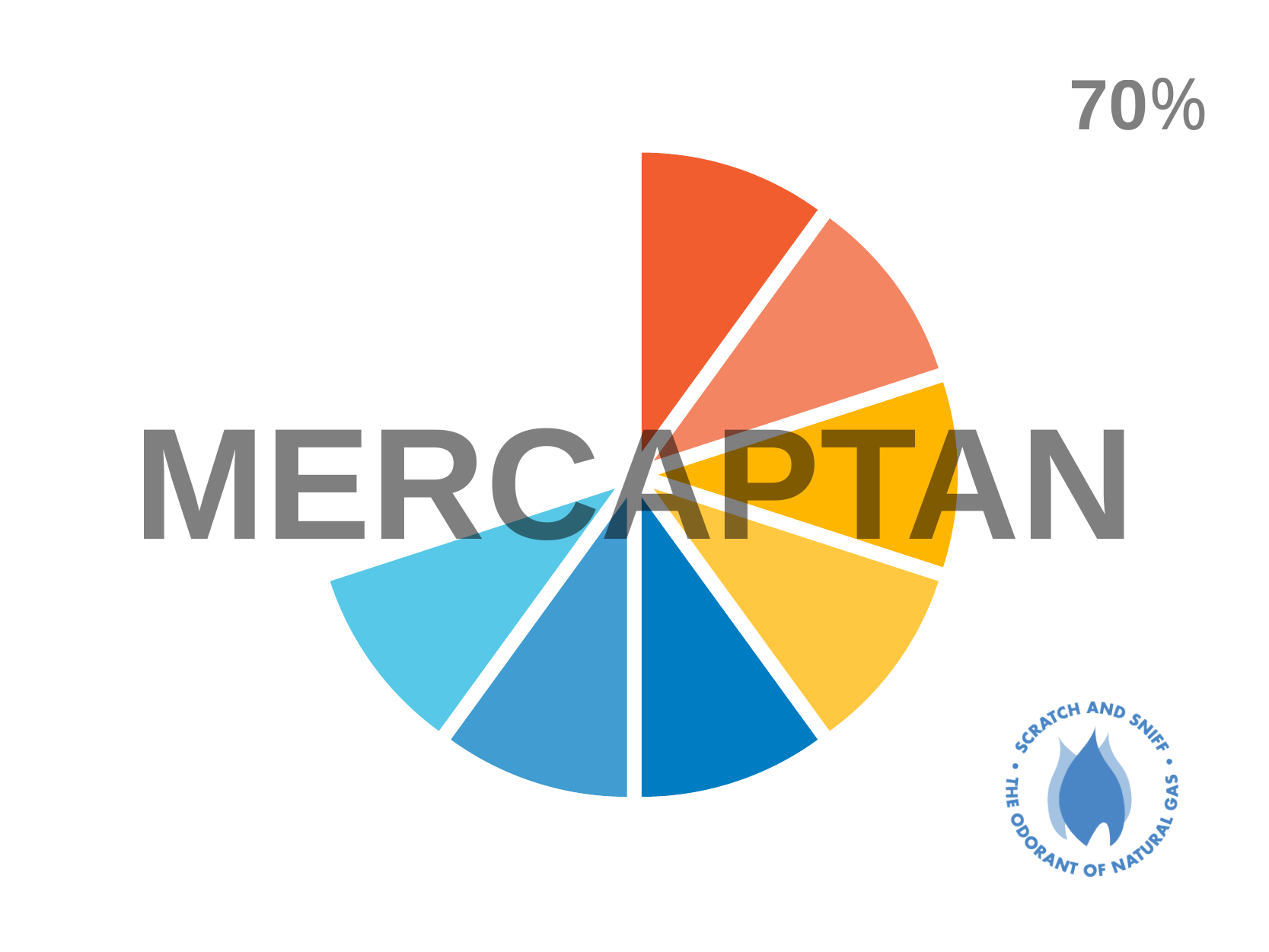
How many coloured slices does the pie chart have? 7 What kind of chart is shown on the slide? pie chart What word is written across the middle of the pie chart? MERCAPTAN Does the pie chart have a legend? No Do the slices of the pie chart fill the whole circle? No What percentage is printed in the top-right corner of the slide? 70%